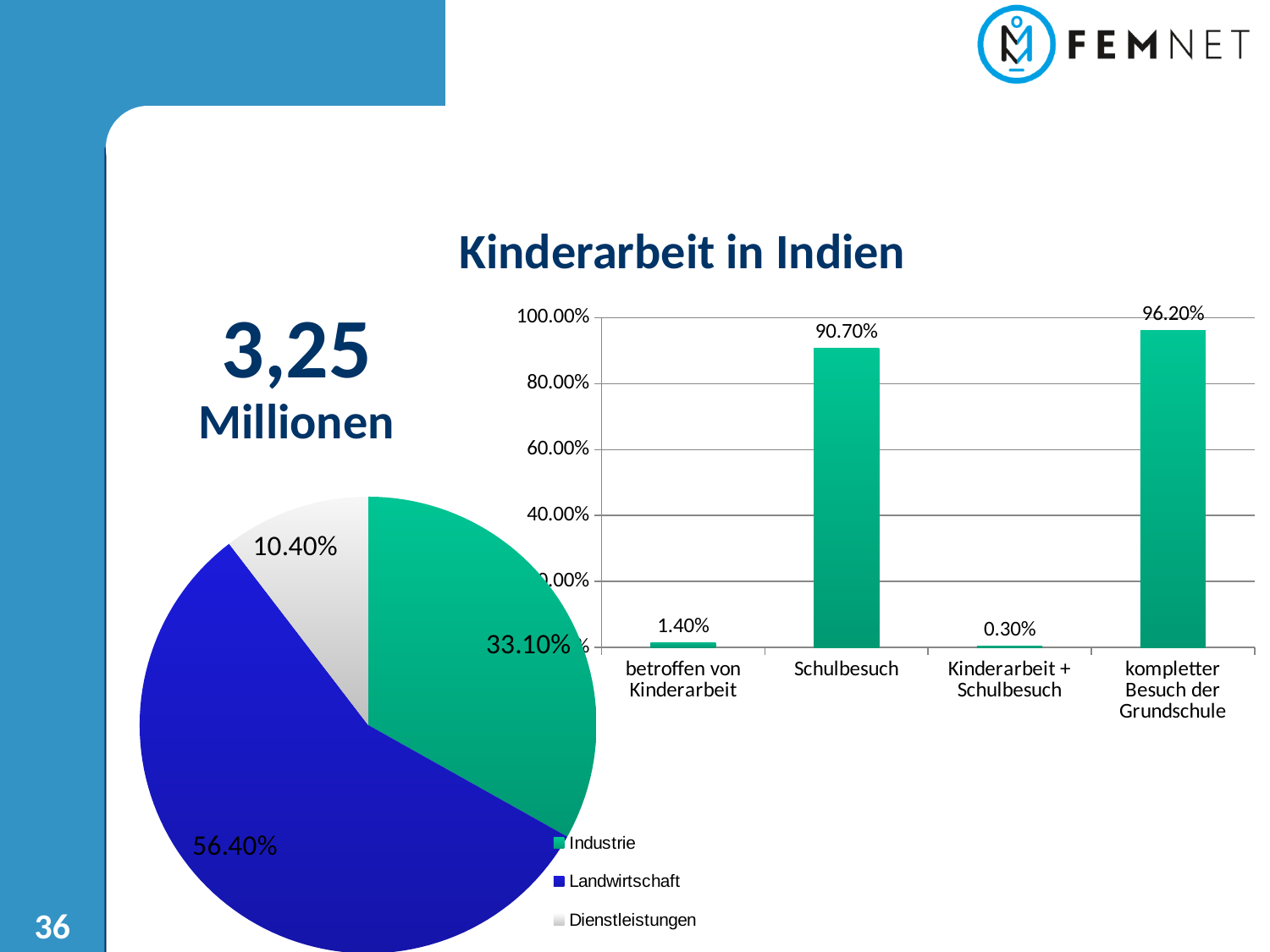
In the bar chart, what is the difference between kompletter Besuch der Grundschule and Schulbesuch? 5.50% What kind of chart is the chart on the right of the slide? bar chart In the bar chart, which category has the highest value? kompletter Besuch der Grundschule How many entries does the pie chart's legend list? 3 In the bar chart, what is the value for kompletter Besuch der Grundschule? 96.20% In the bar chart, what is the value for betroffen von Kinderarbeit? 1.40% In the pie chart, which slice is larger, Industrie or Dienstleistungen? Industrie In the pie chart, what share does Landwirtschaft have? 56.40% In the bar chart, which category has the lowest value? Kinderarbeit + Schulbesuch In the bar chart, how many categories are shown? 4 In the bar chart, what is the value for Schulbesuch? 90.70% In the pie chart, what share does Dienstleistungen have? 10.40%